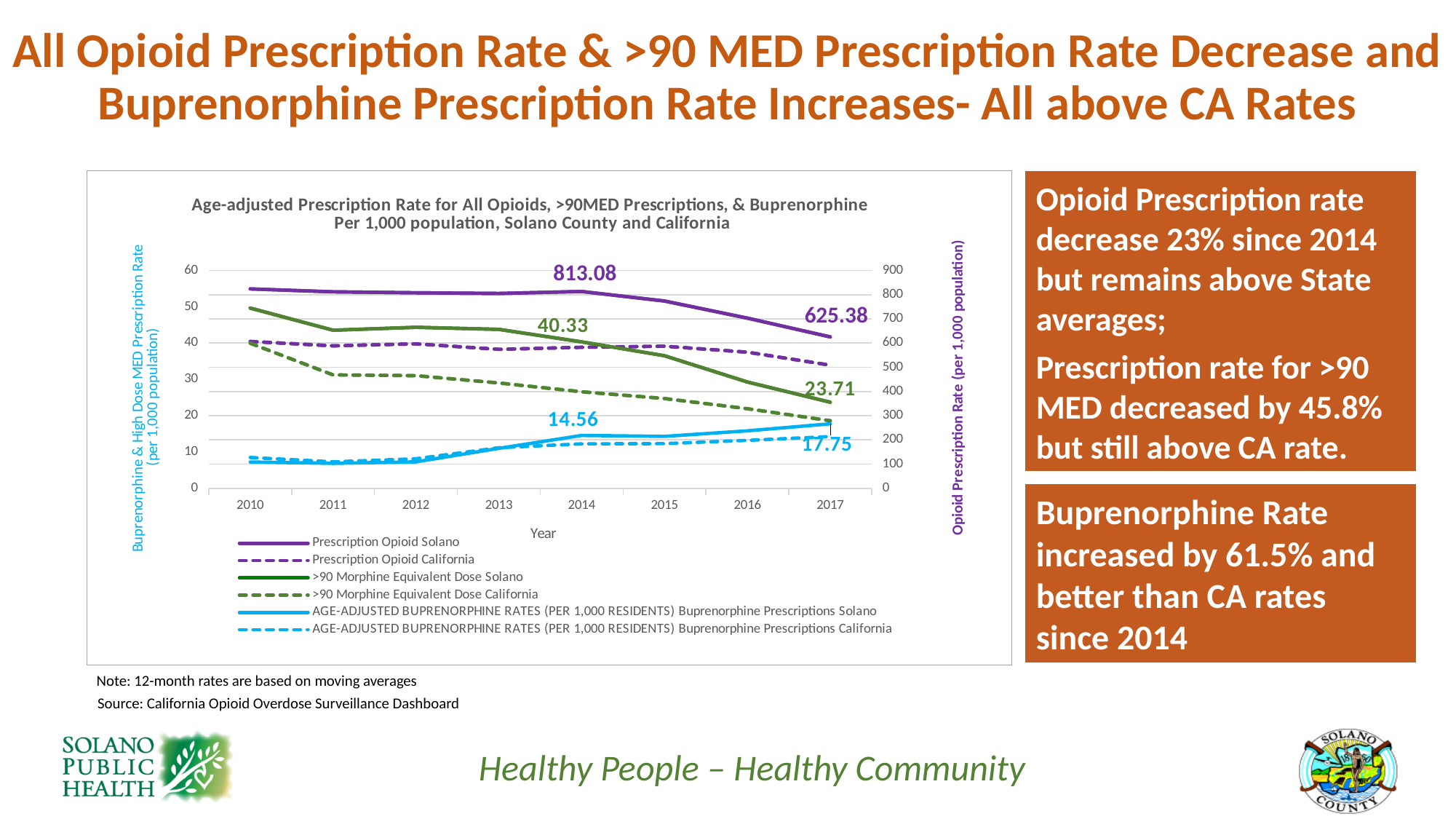
How many series does the legend list? 6 What is the labelled value of the Prescription Opioid Solano series in 2014? 813.08 What is the difference between the labelled Buprenorphine Prescriptions Solano values in 2017 and 2014? 3.19 Is the value for >90 Morphine Equivalent Dose Solano in 2010 greater or less than 40? greater What is the labelled value of the Buprenorphine Prescriptions Solano series in 2017? 17.75 Does the Buprenorphine Prescriptions Solano series rise or fall from 2010 to 2017? Rise By how much did the labelled Prescription Opioid Solano value fall from 2014 to 2017? 187.70 What kind of chart is shown on the slide? Line chart What is the labelled value of the Prescription Opioid Solano series in 2017? 625.38 How many years are shown on the x axis? 8 What is the labelled value of the >90 Morphine Equivalent Dose Solano series in 2017? 23.71 What is the labelled value of the >90 Morphine Equivalent Dose Solano series in 2014? 40.33